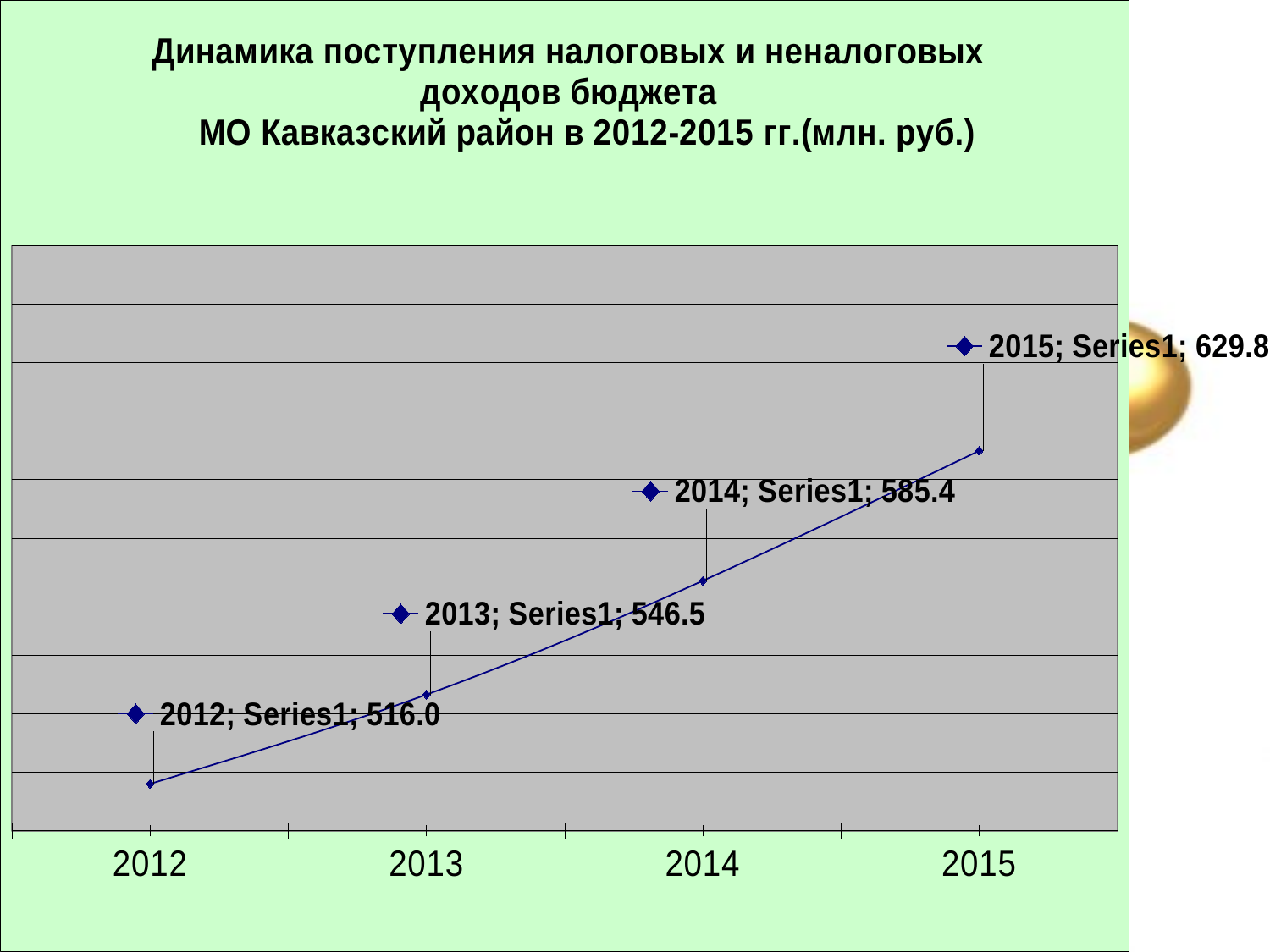
Which year has the lowest value? 2012 What is the difference between the values for 2014 and 2013? 38.9 What is the value for 2012? 516.0 Do the values rise or fall from 2012 to 2015? rise What is the value for 2014? 585.4 What is the difference between the values for 2015 and 2012? 113.8 How many years are plotted on the chart? 4 What kind of chart is shown? line chart What is the value for 2015? 629.8 Which year has the highest value? 2015 What is the value for 2013? 546.5 Which is larger, the value for 2013 or the value for 2014? 2014